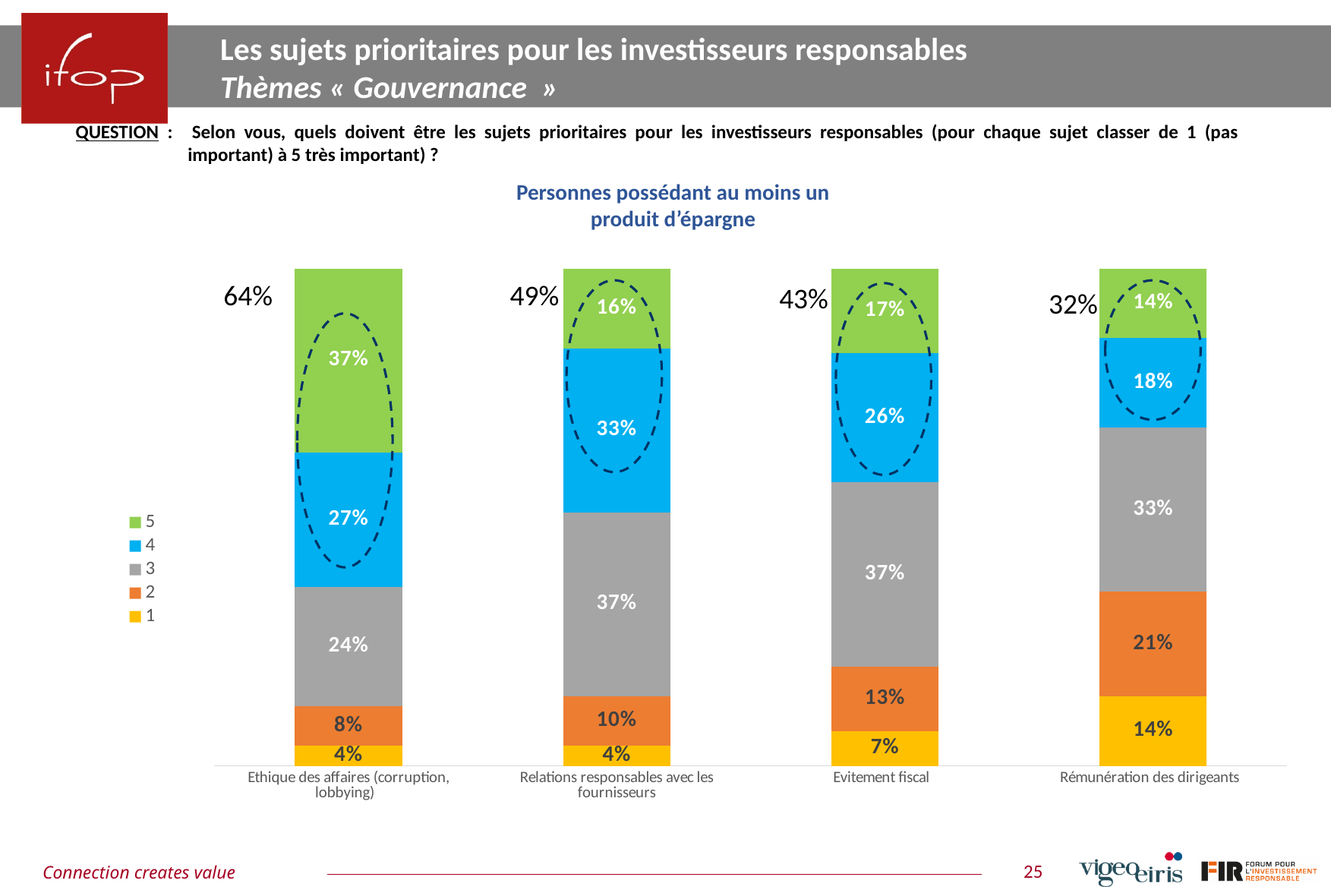
Which is larger: the series 1 value for "Rémunération des dirigeants" or for "Evitement fiscal"? Rémunération des dirigeants How many series does the legend list? 5 What is the value of series 3 for "Rémunération des dirigeants"? 33% Which category has the lowest value for series 4? Rémunération des dirigeants What is the value of series 2 for "Evitement fiscal"? 13% How many categories are shown on the x axis? 4 What is the combined share of ratings 5 and 4 for "Relations responsables avec les fournisseurs"? 49% What is the title shown above the chart? Personnes possédant au moins un produit d'épargne Which category has the highest value for series 5? Ethique des affaires (corruption, lobbying) What kind of chart is shown on the slide? Stacked bar chart What percentage of respondents rated "Ethique des affaires (corruption, lobbying)" as 5? 37% What is the difference between the series 4 values for "Relations responsables avec les fournisseurs" and "Evitement fiscal"? 7%